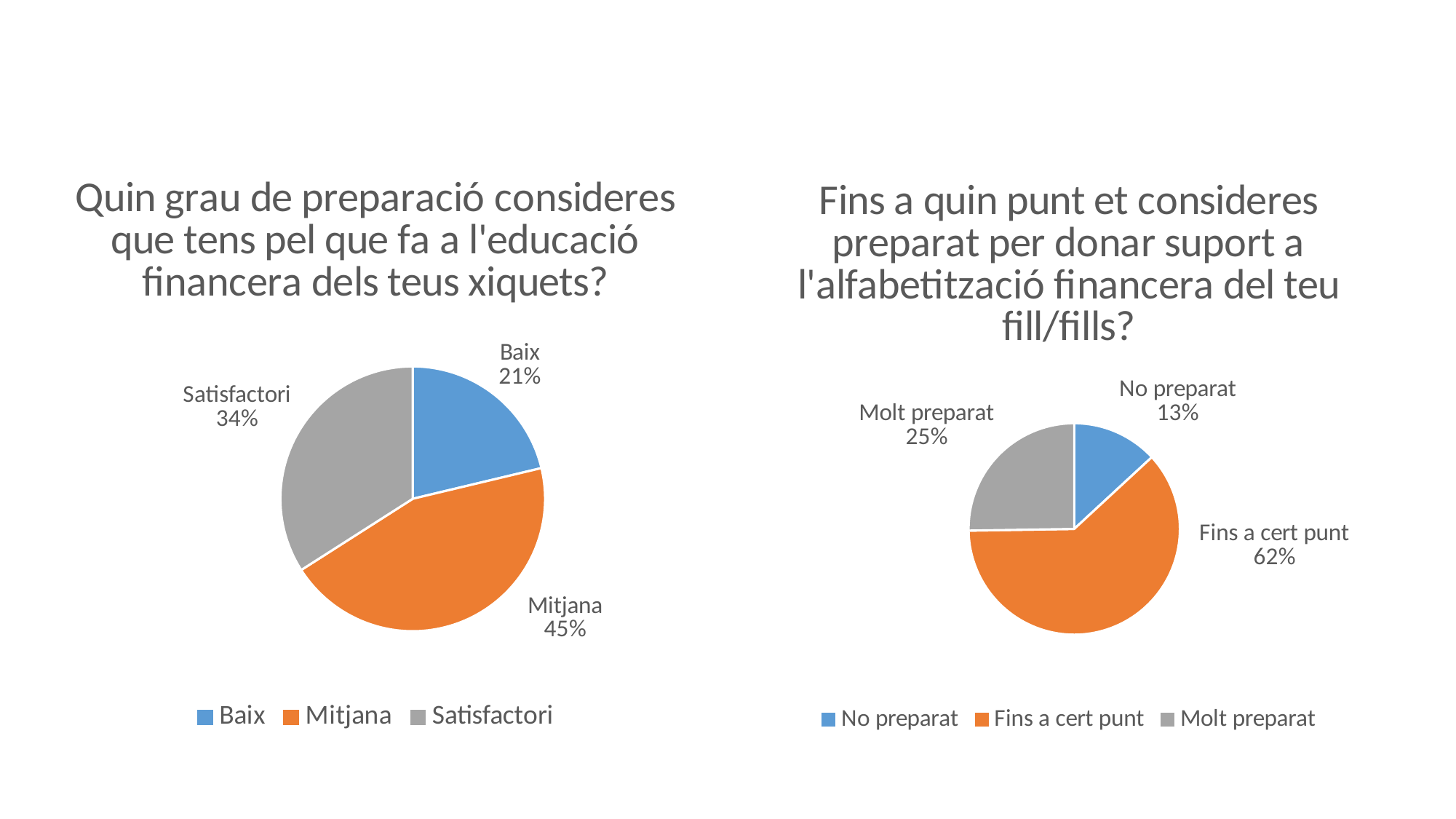
In the left pie chart, what percentage is shown for Mitjana? 45% In the right pie chart, what percentage is shown for No preparat? 13% In the right pie chart, what is the difference in percentage points between Fins a cert punt and Molt preparat? 37 In the left pie chart, how many categories are shown? 3 In the left pie chart, which category has the smallest share? Baix In the left pie chart, what is the difference in percentage points between Mitjana and Satisfactori? 11 In the right pie chart, which category has the smallest share? No preparat In the right pie chart, which is larger: Molt preparat or No preparat? Molt preparat In the right pie chart, what percentage is shown for Fins a cert punt? 62% In the left pie chart, what percentage is shown for Baix? 21% What type of chart is used on the right side of the slide? Pie chart In the left pie chart, which category has the largest share? Mitjana